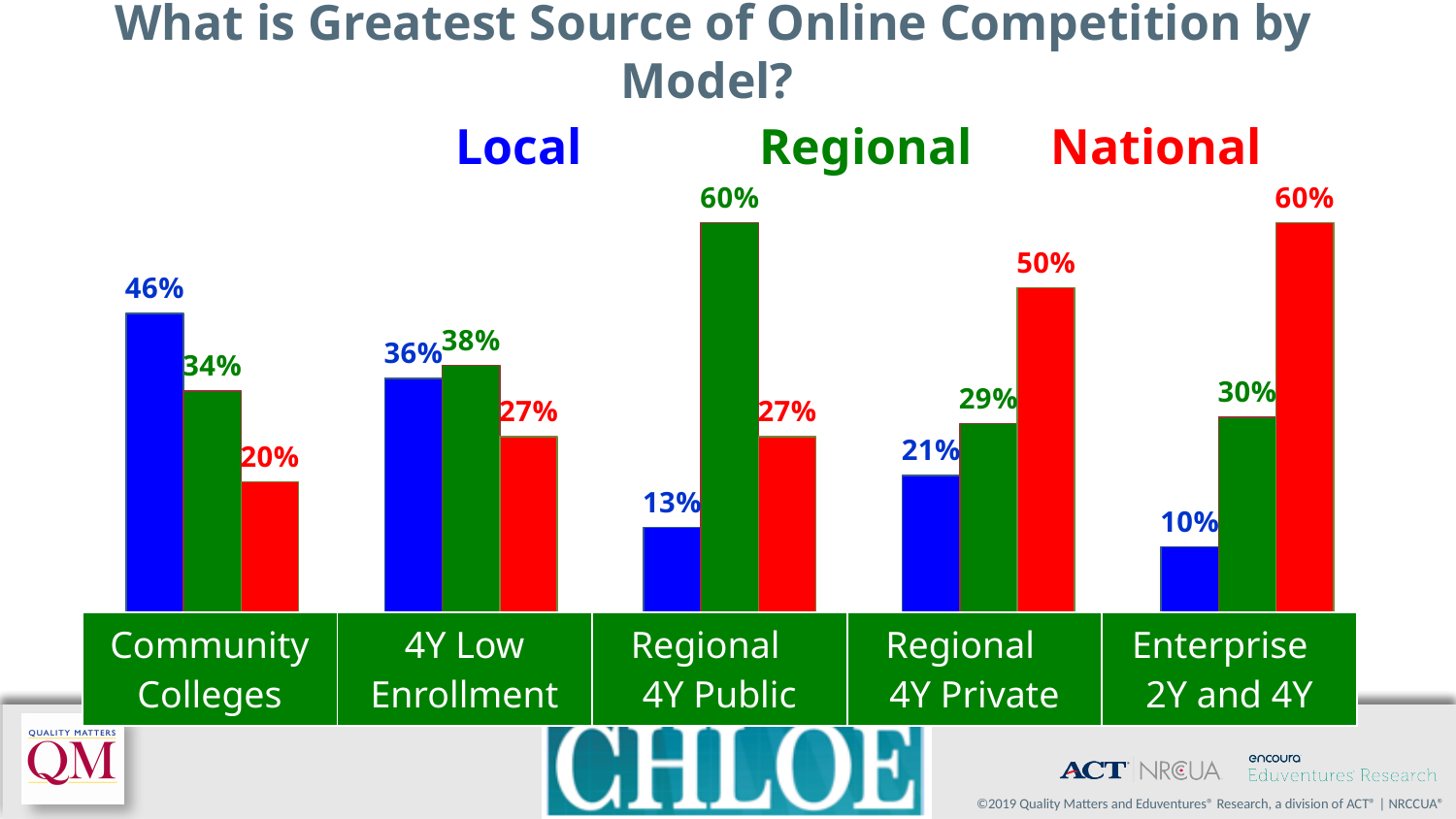
Which category has the highest Local value? Community Colleges Which is larger for 4Y Low Enrollment, the Local value or the Regional value? Regional Which category has the lowest National value? Community Colleges What is the difference between the National and Local values for Enterprise 2Y and 4Y? 50% What is the National value for Regional 4Y Private? 50% What is the Regional value for Regional 4Y Public? 60% Which colour represents the National series? Red How many categories are shown on the x axis? 5 What kind of chart is shown on the slide? Bar chart What is the Local value for Community Colleges? 46% What is the Local value for Enterprise 2Y and 4Y? 10% How many series does the legend list? 3